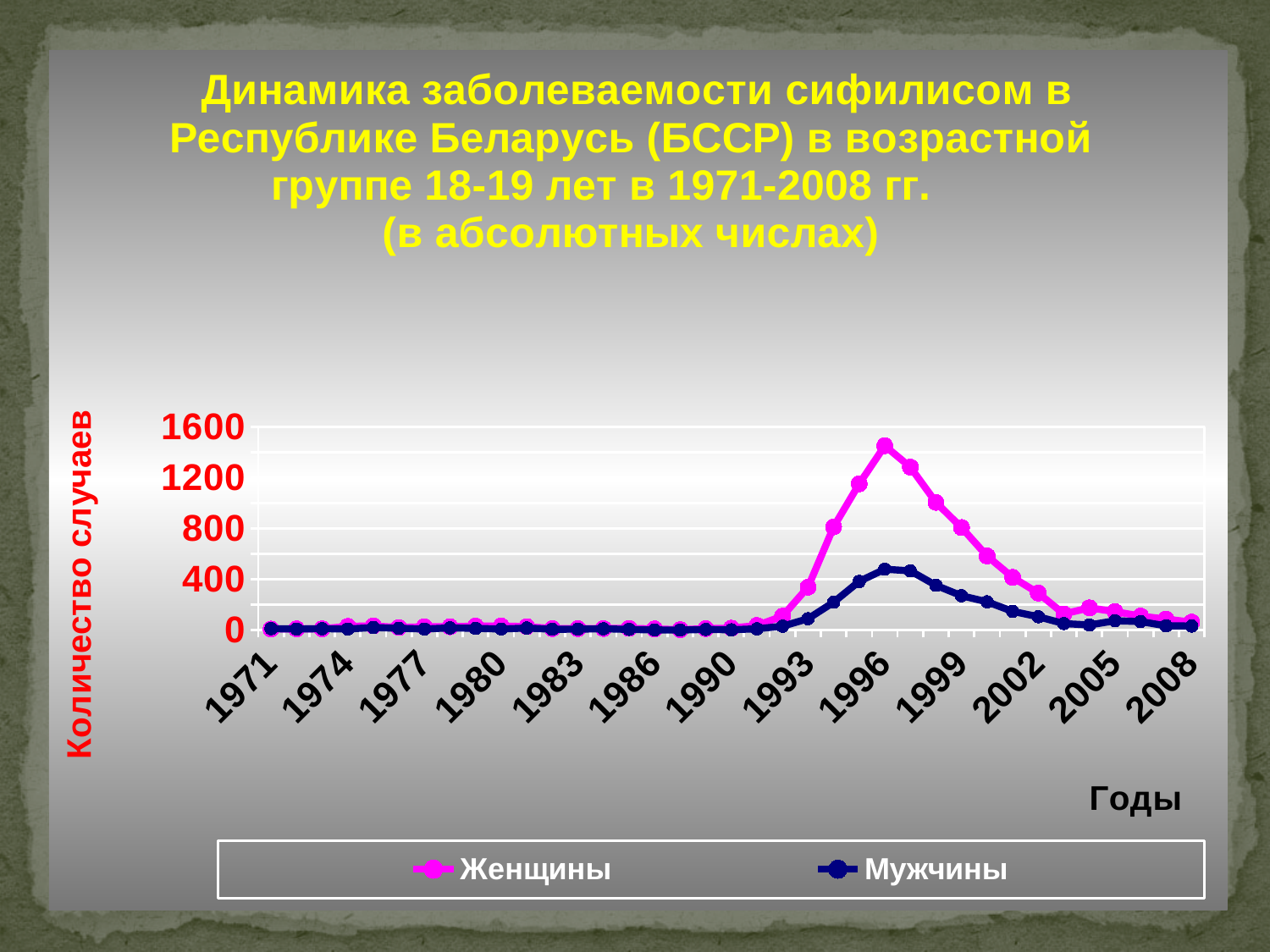
In which year does the Женщины series reach its highest value? 1996 What kind of chart is shown on the slide? line chart Is the value for Мужчины in 1996 greater or less than 800? less What are the two series named in the legend? Женщины and Мужчины How many series does the legend list? 2 Is the value for Женщины in 1971 greater or less than 400? less Is the value for Женщины in 1996 greater or less than 1200? greater In 1996, which series has the higher value, Женщины or Мужчины? Женщины What is the label of the vertical axis? Количество случаев Does the Женщины series rise or fall between 1996 and 2008? fall